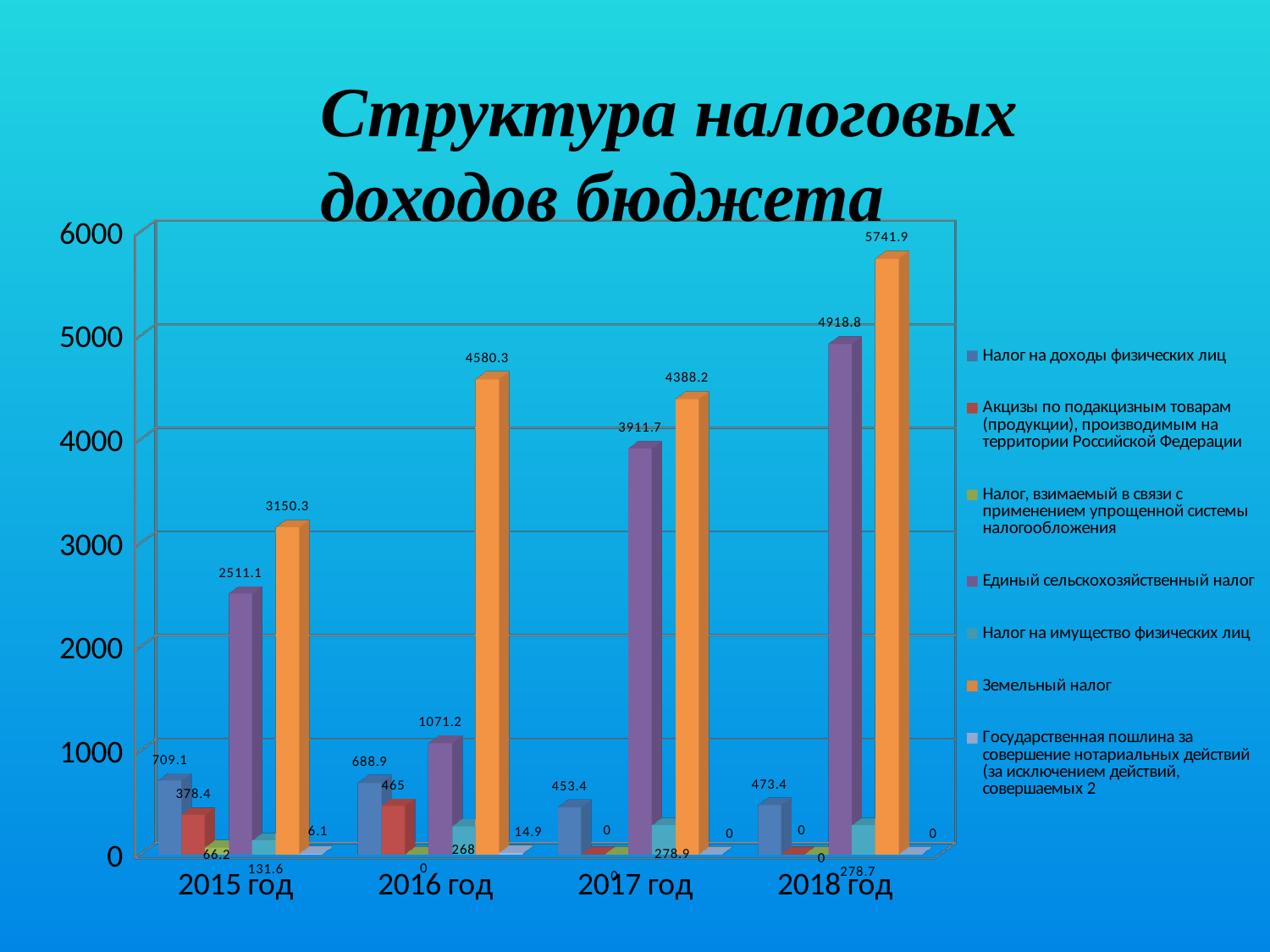
What is the value of Земельный налог for 2018 год? 5741.9 What is the value of Акцизы по подакцизным товарам for 2016 год? 465 In which year is Земельный налог the highest? 2018 год How many years are shown on the x axis? 4 In 2016 год, which is larger: Единый сельскохозяйственный налог or Налог на доходы физических лиц? Единый сельскохозяйственный налог What kind of chart is shown on the slide? bar chart What is the difference between Земельный налог in 2018 год and in 2015 год? 2591.6 Is the value of Единый сельскохозяйственный налог for 2018 год greater or less than 4000? greater What is the value of Единый сельскохозяйственный налог for 2017 год? 3911.7 How many series does the legend list? 7 In which year is Налог на доходы физических лиц the lowest? 2017 год What is the value of Налог на имущество физических лиц for 2015 год? 131.6